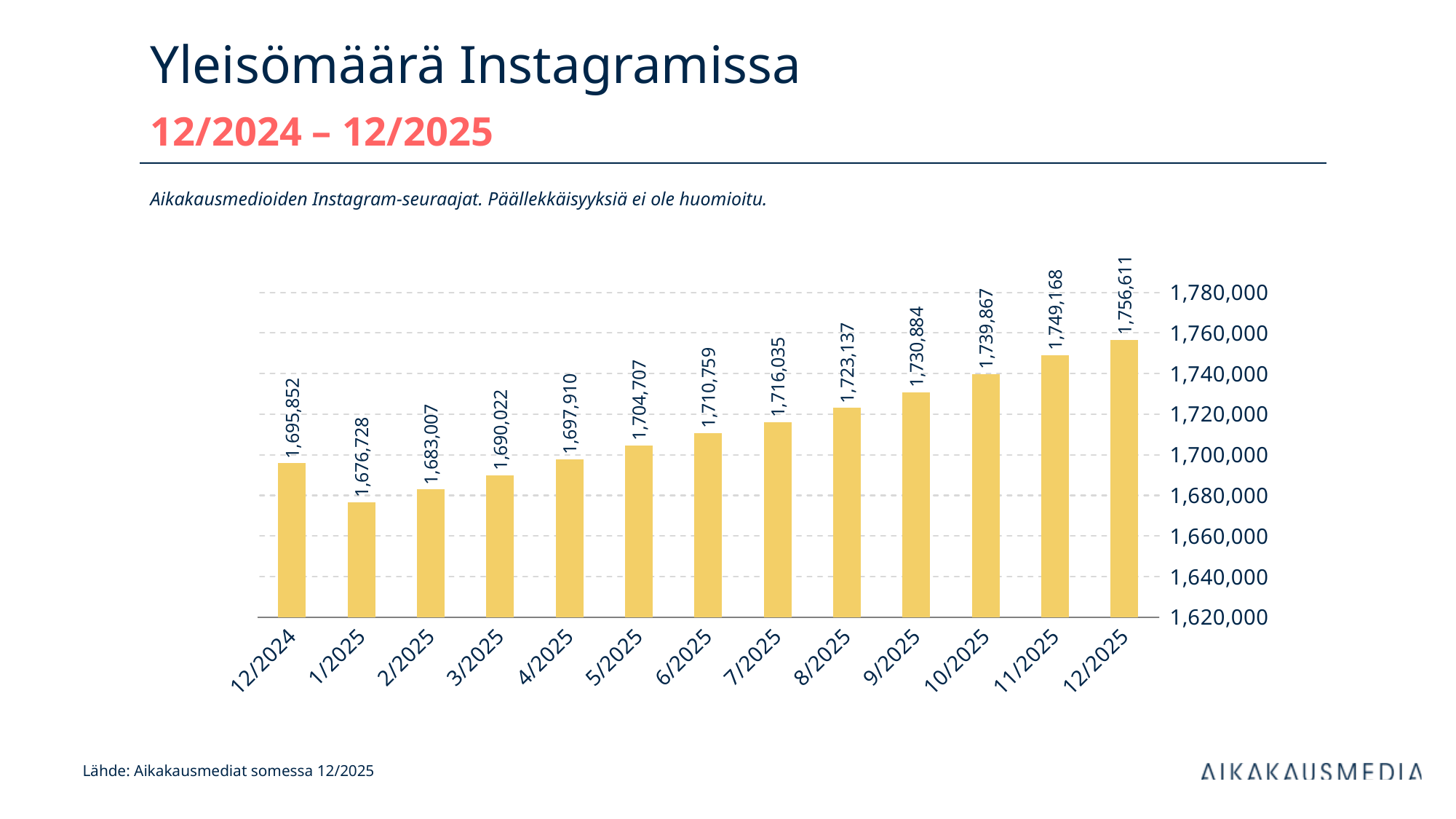
Do the values rise or fall from 1/2025 to 12/2025? rise What is the title of the chart slide? Yleisömäärä Instagramissa How many months (bars) are shown in the chart? 13 What is the value shown for 6/2025? 1,710,759 What is the difference between the values for 12/2024 and 1/2025? 19,124 What is the Instagram audience value for 12/2024? 1,695,852 Which is larger, the value for 12/2024 or the value for 3/2025? 12/2024 What type of chart is shown on the slide? bar chart Which month has the highest value in the chart? 12/2025 Which month has the lowest value in the chart? 1/2025 What is the difference between the values for 12/2025 and 12/2024? 60,759 What is the value shown for 12/2025? 1,756,611